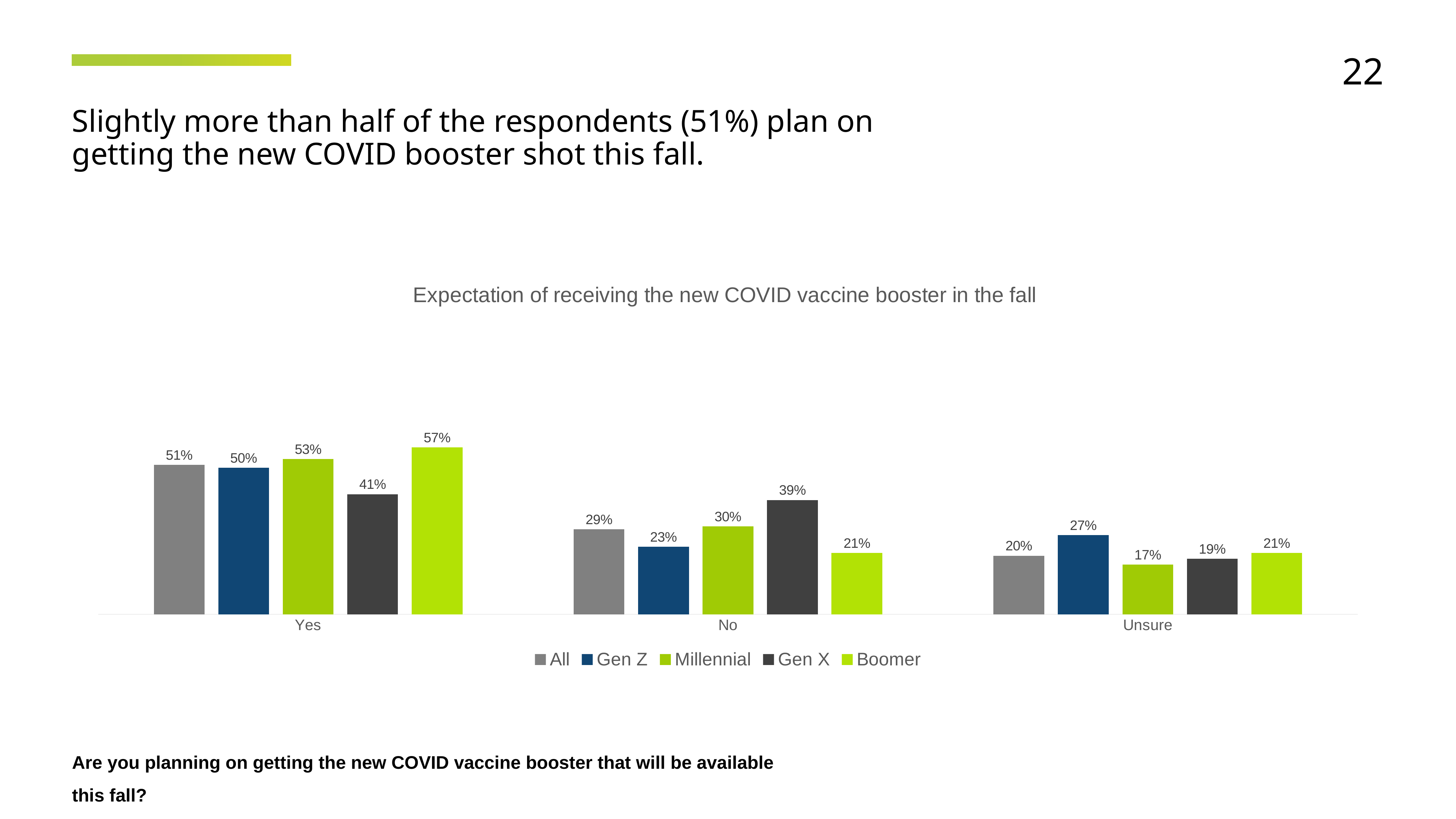
How many series does the legend list? 5 What is the value for All in the No category? 29% Which series has the highest value in the Yes category? Boomer What is the difference between the Boomer and Gen X values in the Yes category? 16% What is the value for Gen X in the No category? 39% What kind of chart is shown on the slide? Bar chart What percentage of Millennial respondents answered Unsure? 17% What is the title of the chart? Expectation of receiving the new COVID vaccine booster in the fall How many categories are shown on the x axis? 3 Which is larger: the Gen Z value for No or the Gen Z value for Unsure? Unsure What percentage of Boomer respondents answered Yes? 57% Which series has the lowest value in the Unsure category? Millennial